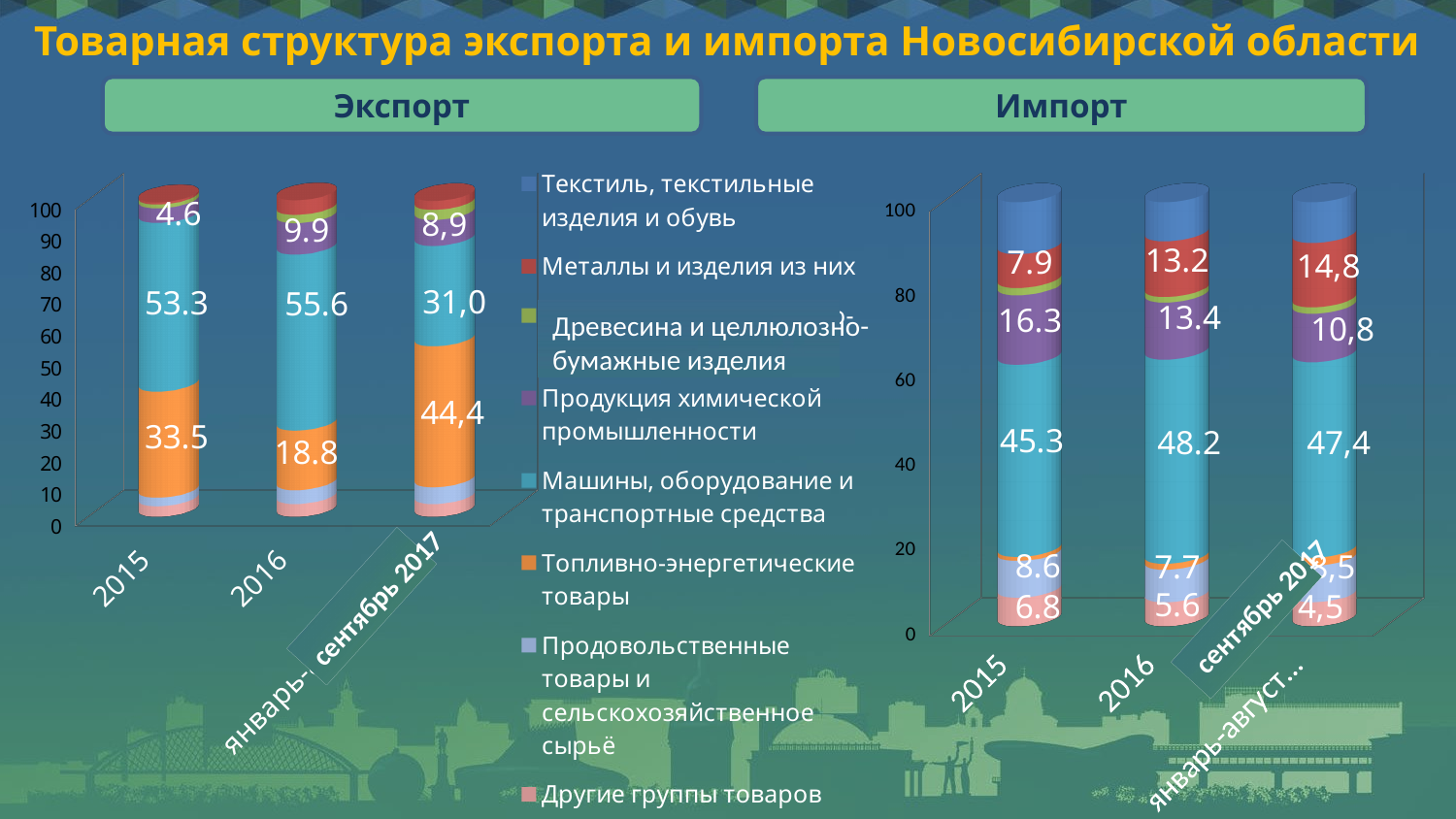
On the Импорт chart, what is the value for Машины, оборудование и транспортные средства in 2016? 48.2 On the Экспорт chart, what is the difference between the values for Машины, оборудование и транспортные средства in 2016 and 2015? 2.3 On the Экспорт chart, what is the value for Машины, оборудование и транспортные средства in 2016? 55.6 On the Импорт chart, is the value for Металлы и изделия из них larger in 2015 or in 2016? 2016 On the Экспорт chart, what is the value for Топливно-энергетические товары in 2015? 33.5 On the Импорт chart, what is the value for Продукция химической промышленности in 2015? 16.3 On the Импорт chart, does the value for Продукция химической промышленности rise or fall from 2015 to the last period? fall What kind of chart is the Экспорт chart? stacked bar chart On the Экспорт chart, what is the value for Топливно-энергетические товары in январь-сентябрь 2017? 44,4 How many series does the legend list? 8 On the Экспорт chart, in which period is the value for Топливно-энергетические товары the highest? январь-сентябрь 2017 On the Импорт chart, what is the value for Металлы и изделия из них in 2015? 7.9